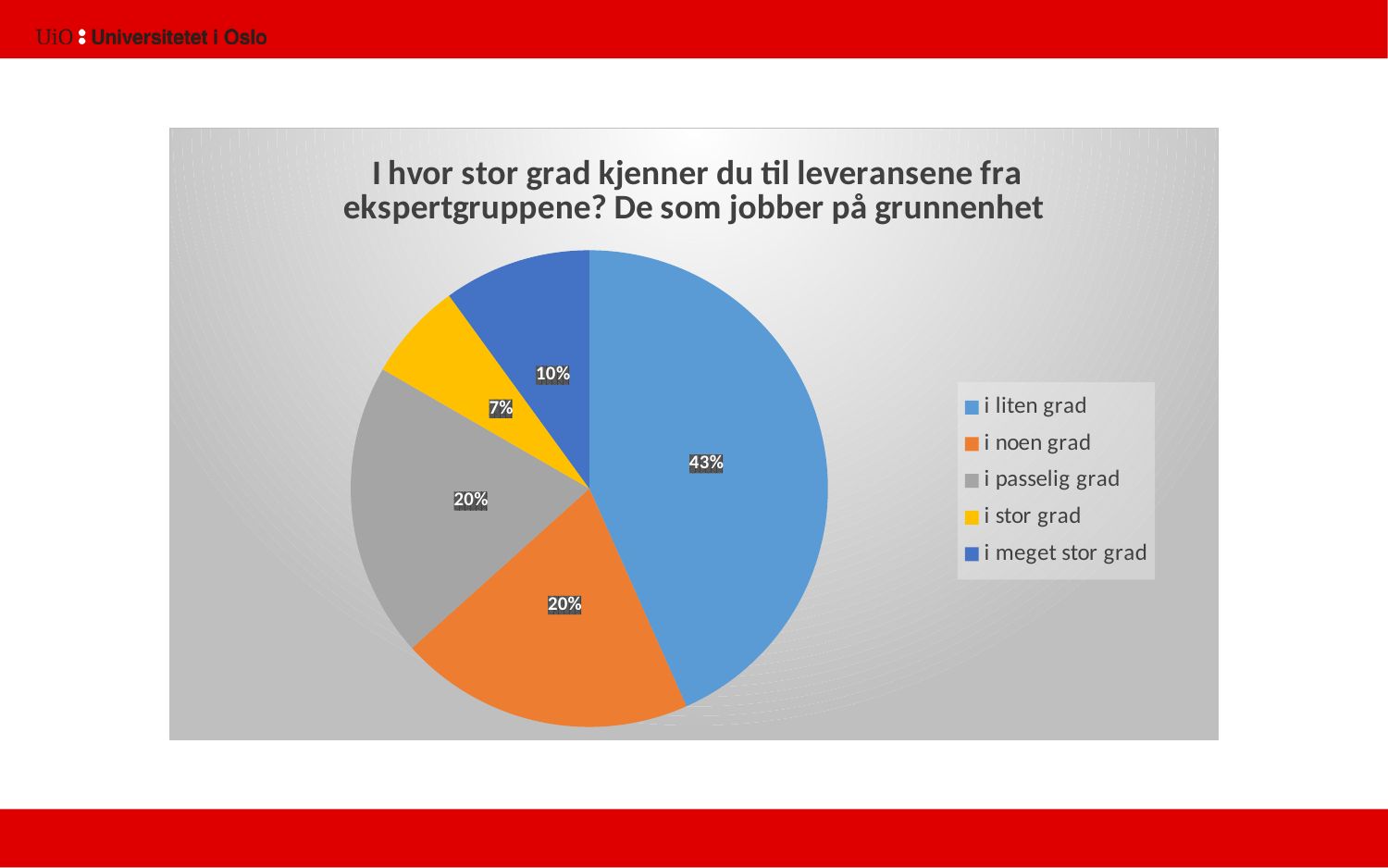
What is the difference between the values for "i liten grad" and "i meget stor grad"? 33% Which category has the largest slice of the pie? i liten grad Which category has the smallest slice of the pie? i stor grad What share of the pie does "i liten grad" represent? 43% Which is larger, the value for "i meget stor grad" or the value for "i stor grad"? i meget stor grad How many categories does the legend list? 5 What is the value shown for "i stor grad"? 7% What kind of chart is shown on the slide? pie chart What is the value shown for "i passelig grad"? 20% What is the value shown for "i meget stor grad"? 10% What is the value shown for "i noen grad"? 20% What colour is the slice for "i stor grad"? yellow